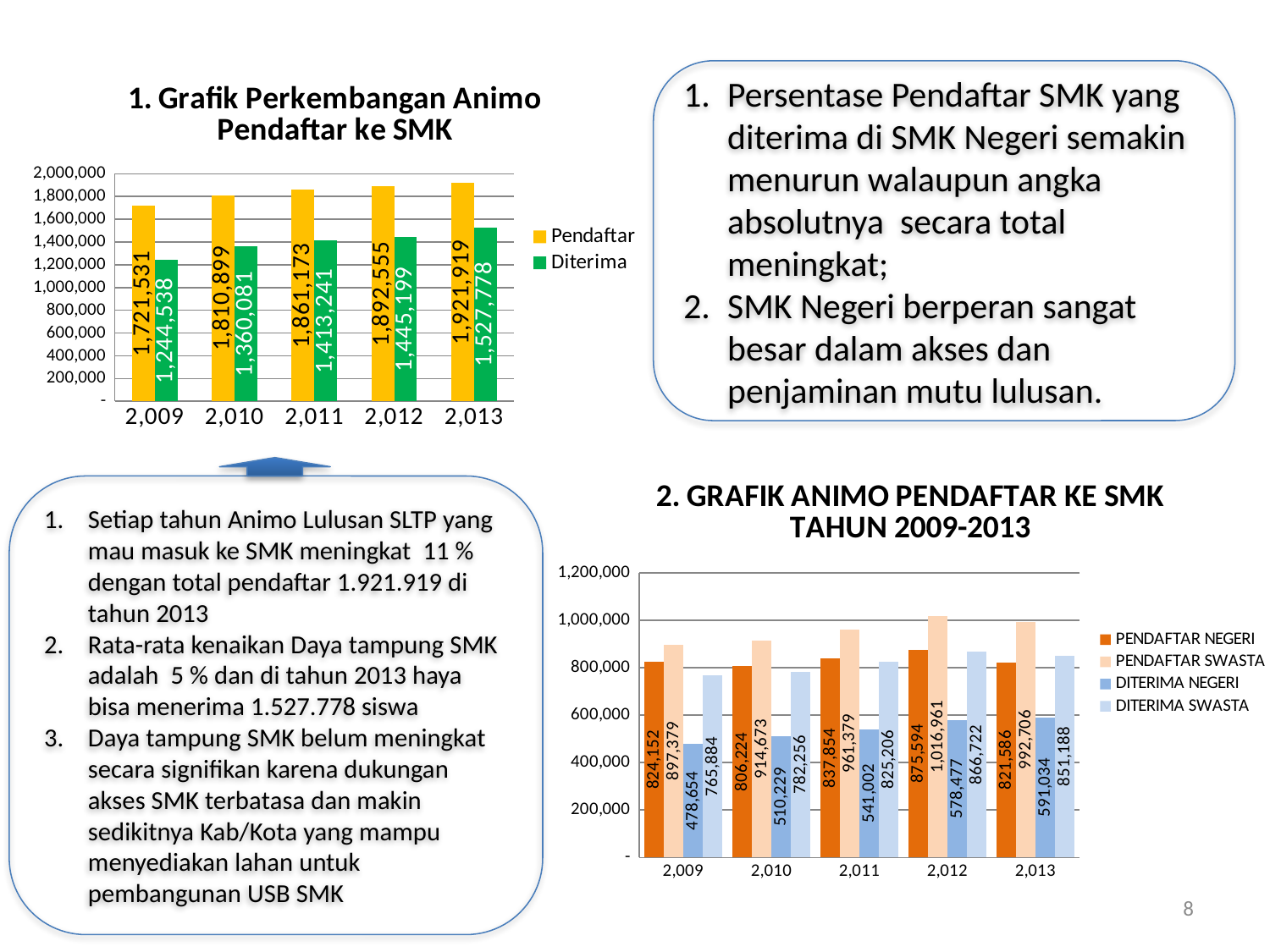
In the chart titled '2. GRAFIK ANIMO PENDAFTAR KE SMK TAHUN 2009-2013', what is the PENDAFTAR SWASTA value for 2,012? 1,016,961 In the chart titled '1. Grafik Perkembangan Animo Pendaftar ke SMK', what is the Diterima value for 2,009? 1,244,538 In the chart titled '1. Grafik Perkembangan Animo Pendaftar ke SMK', which year has the lowest Pendaftar value? 2,009 What kind of chart is the one titled '2. GRAFIK ANIMO PENDAFTAR KE SMK TAHUN 2009-2013'? bar chart In the chart titled '2. GRAFIK ANIMO PENDAFTAR KE SMK TAHUN 2009-2013', how many series does the legend list? 4 In the chart titled '1. Grafik Perkembangan Animo Pendaftar ke SMK', does the Diterima series rise or fall from 2,009 to 2,013? rise In the chart titled '1. Grafik Perkembangan Animo Pendaftar ke SMK', what is the Pendaftar value for 2,013? 1,921,919 In the chart titled '2. GRAFIK ANIMO PENDAFTAR KE SMK TAHUN 2009-2013', which is larger in 2,010: PENDAFTAR NEGERI or PENDAFTAR SWASTA? PENDAFTAR SWASTA In the chart titled '1. Grafik Perkembangan Animo Pendaftar ke SMK', what is the difference between Pendaftar and Diterima in 2,011? 447,932 In the chart titled '2. GRAFIK ANIMO PENDAFTAR KE SMK TAHUN 2009-2013', what is the DITERIMA NEGERI value for 2,013? 591,034 In the chart titled '1. Grafik Perkembangan Animo Pendaftar ke SMK', how many series does the legend list? 2 In the chart titled '2. GRAFIK ANIMO PENDAFTAR KE SMK TAHUN 2009-2013', which year has the highest PENDAFTAR NEGERI value? 2,012